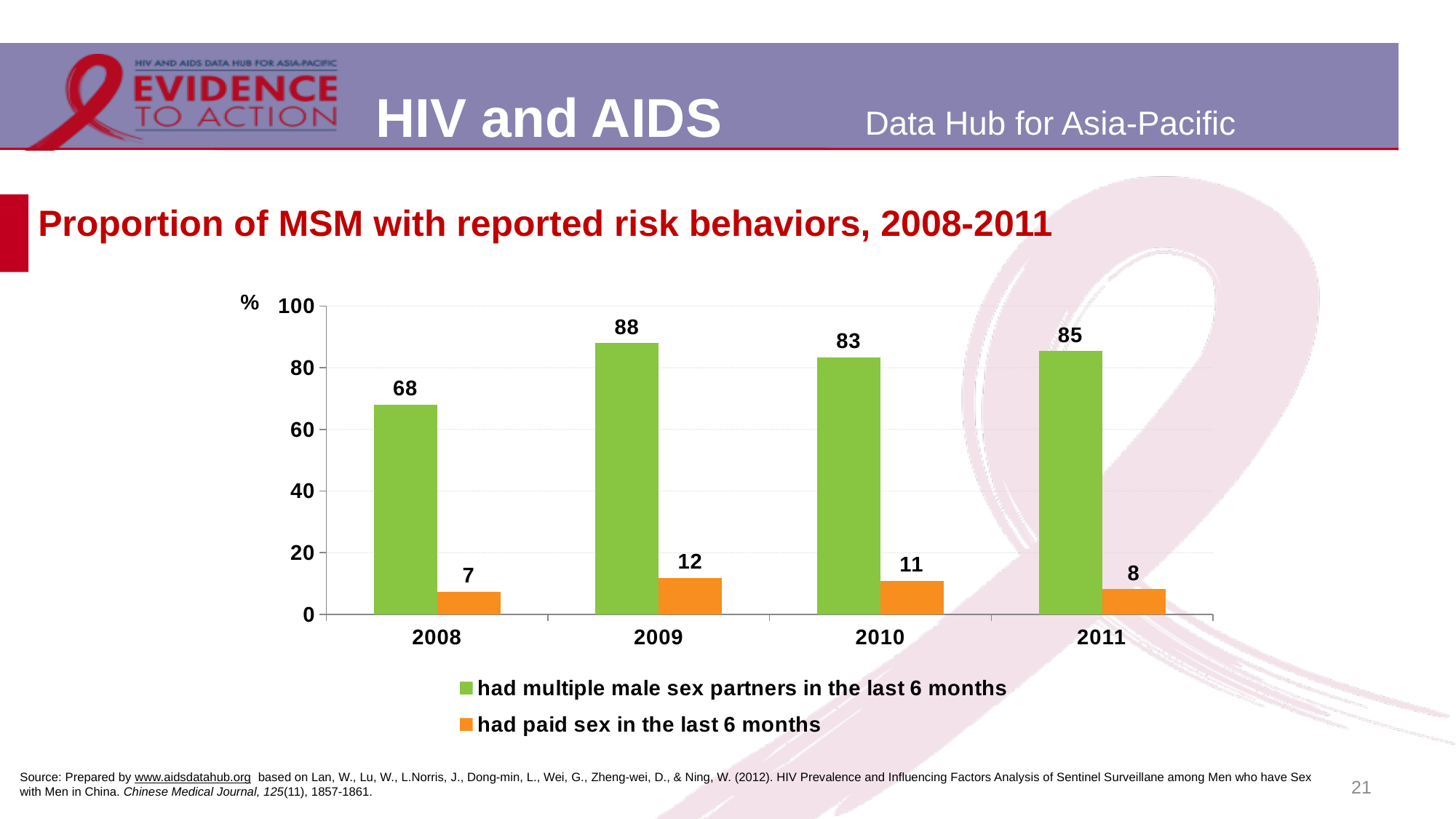
What percentage of MSM had multiple male sex partners in the last 6 months in 2009? 88 How many years are shown on the x axis? 4 In which year was the proportion of MSM who had paid sex in the last 6 months lowest? 2008 What is the difference between the 2009 and 2008 values for 'had multiple male sex partners in the last 6 months'? 20 What kind of chart is shown on the slide? Bar chart Which colour represents 'had paid sex in the last 6 months'? Orange What percentage of MSM had paid sex in the last 6 months in 2011? 8 In which year was the proportion of MSM who had multiple male sex partners in the last 6 months highest? 2009 What is the value for 'had multiple male sex partners in the last 6 months' in 2008? 68 Did the proportion of MSM who had multiple male sex partners rise or fall from 2008 to 2009? Rise How many series does the legend list? 2 Which is larger: the 2010 value for 'had paid sex in the last 6 months' or the 2011 value? 2010